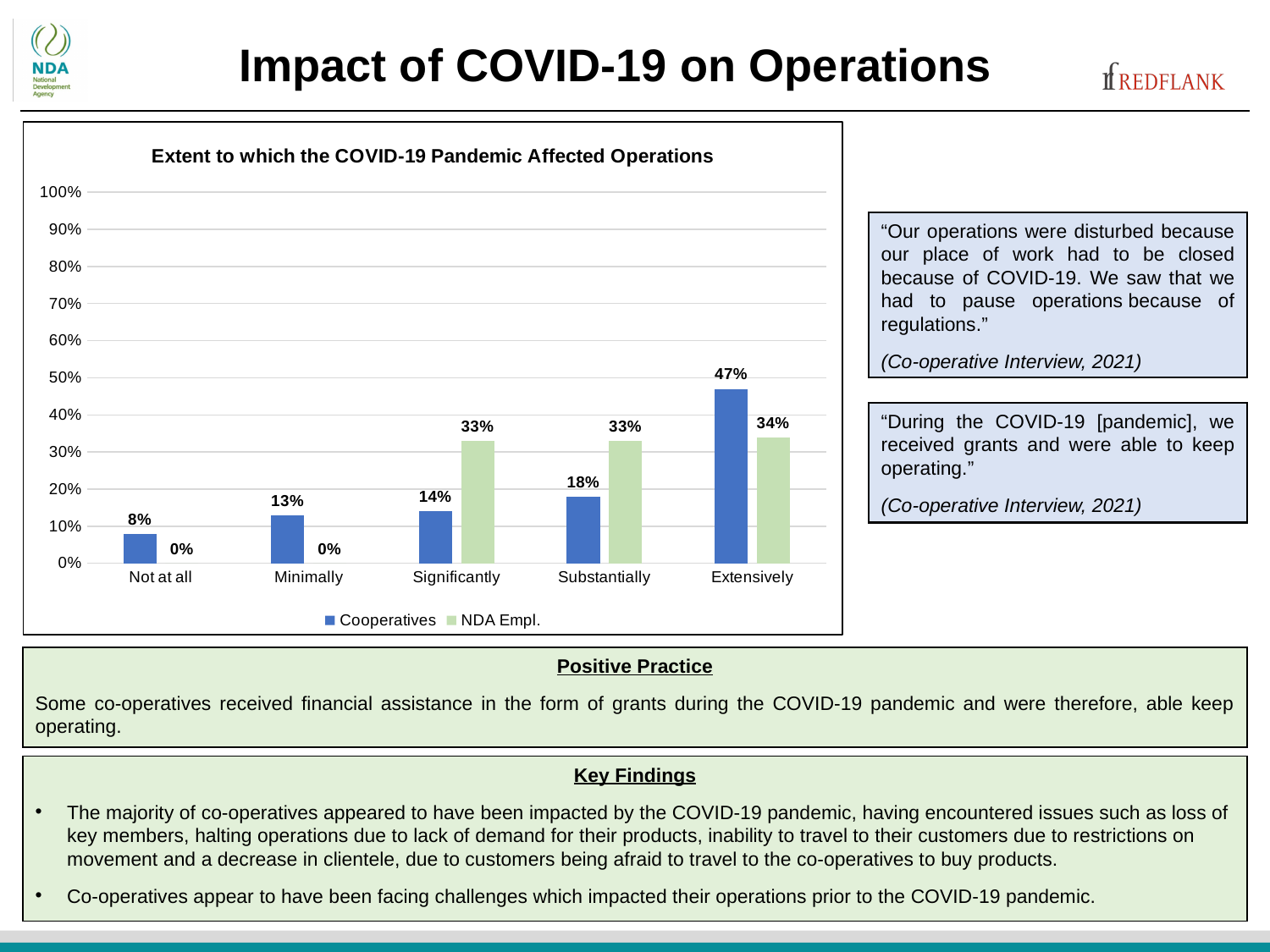
Which is larger in the Substantially category, Cooperatives or NDA Empl.? NDA Empl. Which category has the highest value for Cooperatives? Extensively How many series does the legend list? 2 What kind of chart is shown on the slide? Bar chart Which category has the lowest value for Cooperatives? Not at all What is the difference between the Cooperatives and NDA Empl. values in the Extensively category? 13% What is the title of the chart? Extent to which the COVID-19 Pandemic Affected Operations What is the value for Cooperatives in the Extensively category? 47% What is the difference between the Cooperatives values for Substantially and Significantly? 4% How many categories are shown on the x axis? 5 What is the value for Cooperatives in the Not at all category? 8% What is the value for NDA Empl. in the Significantly category? 33%